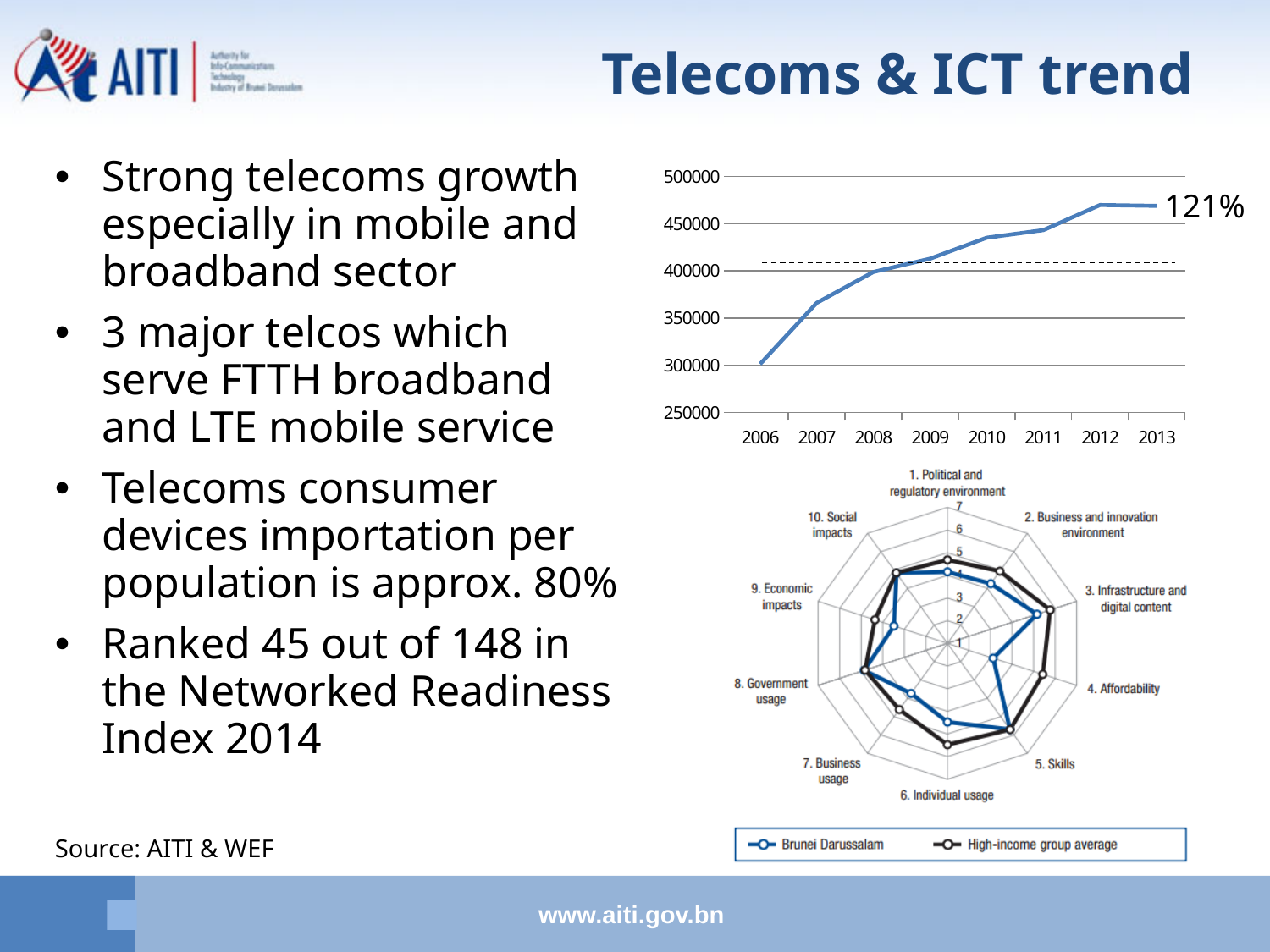
What kind of chart is the top-right chart on the slide? line chart In the top-right line chart, what percentage label is printed at the end of the line? 121% In the top-right line chart, which year has the lowest value? 2006 In the top-right line chart, how many years are shown on the x axis? 8 In the bottom-right radar chart, how many series does the legend list? 2 In the bottom-right radar chart, how many categories (axes) are there? 10 What kind of chart is the bottom-right chart on the slide? radar chart In the top-right line chart, is the value for 2013 greater or less than 450000? greater In the top-right line chart, which is larger, the value for 2007 or the value for 2011? 2011 In the top-right line chart, is the value for 2006 greater or less than 350000? less In the top-right line chart, is the value for 2010 greater or less than 400000? greater In the top-right line chart, does the value rise or fall from 2006 to 2013? rise